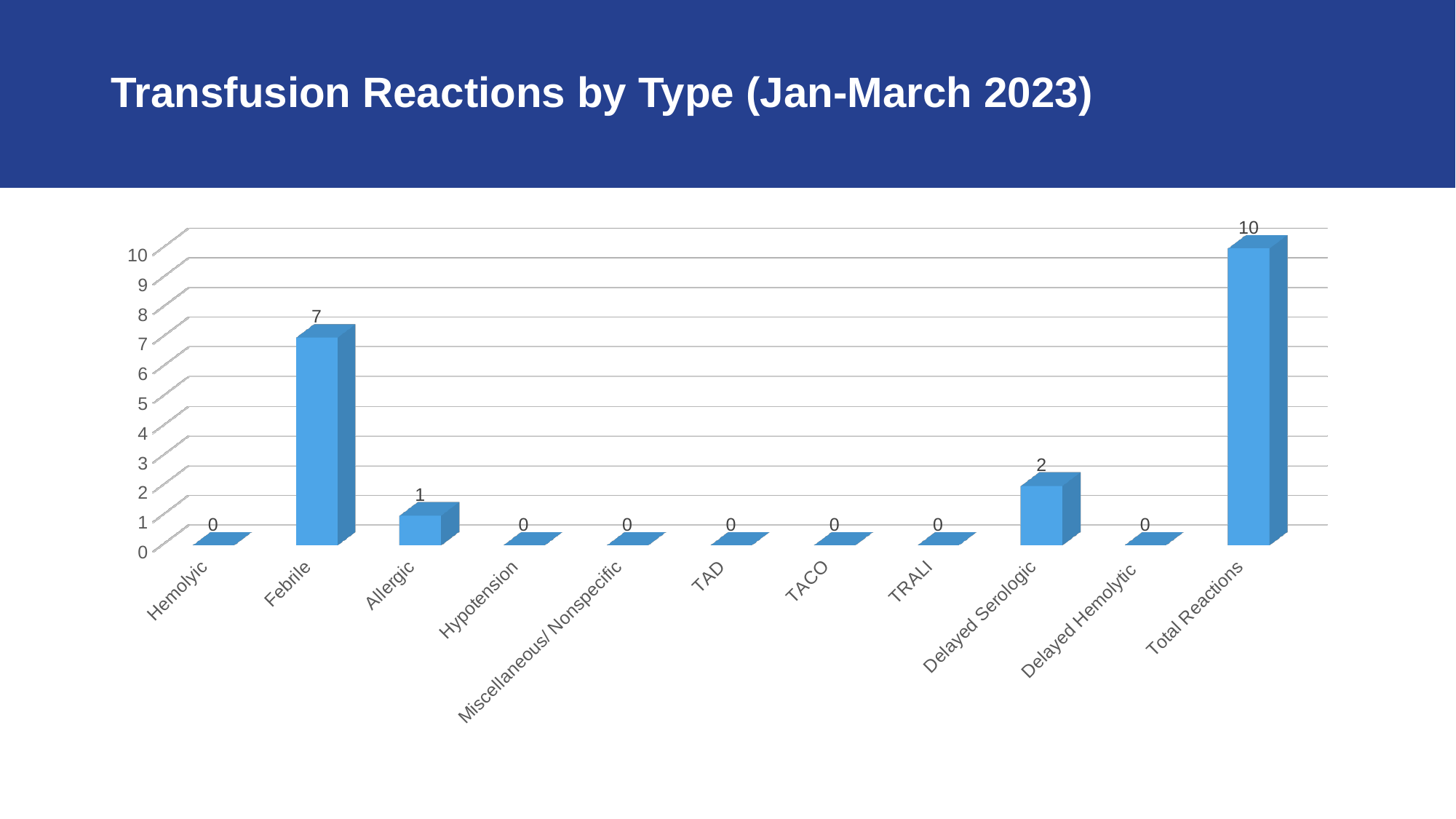
How many categories are shown on the x axis? 11 What is the difference between the values for Febrile and Delayed Serologic? 5 What is the value for Allergic? 1 Which is larger, the value for Allergic or the value for Delayed Serologic? Delayed Serologic What is the value for Febrile? 7 Excluding Total Reactions, which reaction type has the highest value? Febrile What is the value for Total Reactions? 10 What is the value for Delayed Serologic? 2 Which category has the highest value? Total Reactions What kind of chart is shown on the slide? Bar chart What is the value for TACO? 0 What is the title of the slide? Transfusion Reactions by Type (Jan-March 2023)